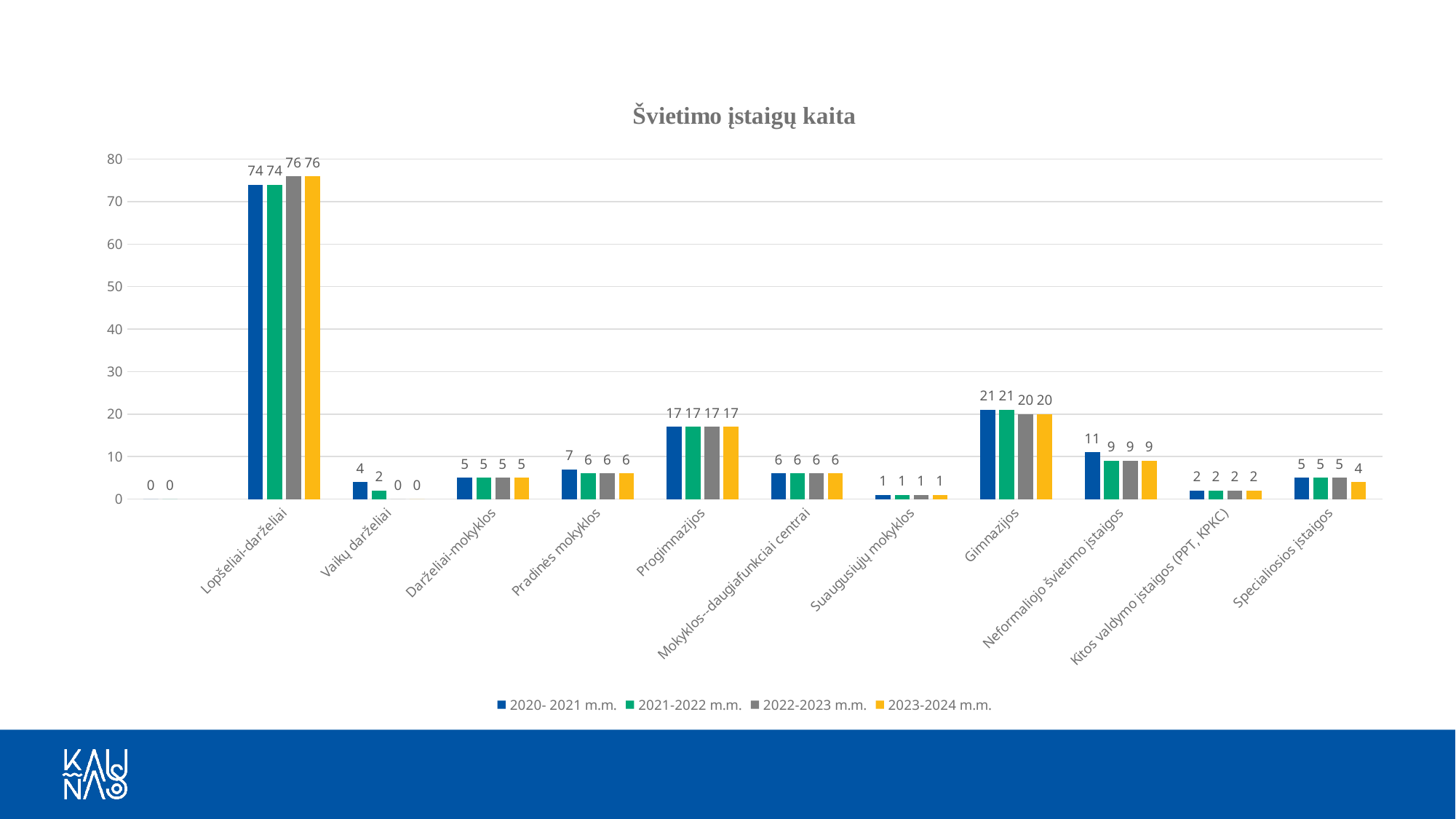
What is the difference between the 2020- 2021 m.m. and 2021-2022 m.m. values for Neformaliojo švietimo įstaigos? 2 What is the title of the chart? Švietimo įstaigų kaita What is the value for Gimnazijos in the 2020- 2021 m.m. series? 21 Which category has the highest value in the 2022-2023 m.m. series? Lopšeliai-darželiai What is the value for Specialiosios įstaigos in the 2023-2024 m.m. series? 4 What is the value for Lopšeliai-darželiai in the 2023-2024 m.m. series? 76 What kind of chart is shown on the slide? Bar chart What is the difference between the 2023-2024 m.m. and 2020- 2021 m.m. values for Lopšeliai-darželiai? 2 How many series does the legend list? 4 What is the value for Neformaliojo švietimo įstaigos in the 2020- 2021 m.m. series? 11 Which is larger: the 2020- 2021 m.m. value for Progimnazijos or the 2020- 2021 m.m. value for Gimnazijos? Gimnazijos Which category has the lowest value in the 2020- 2021 m.m. series among the labelled categories? Suaugusiųjų mokyklos